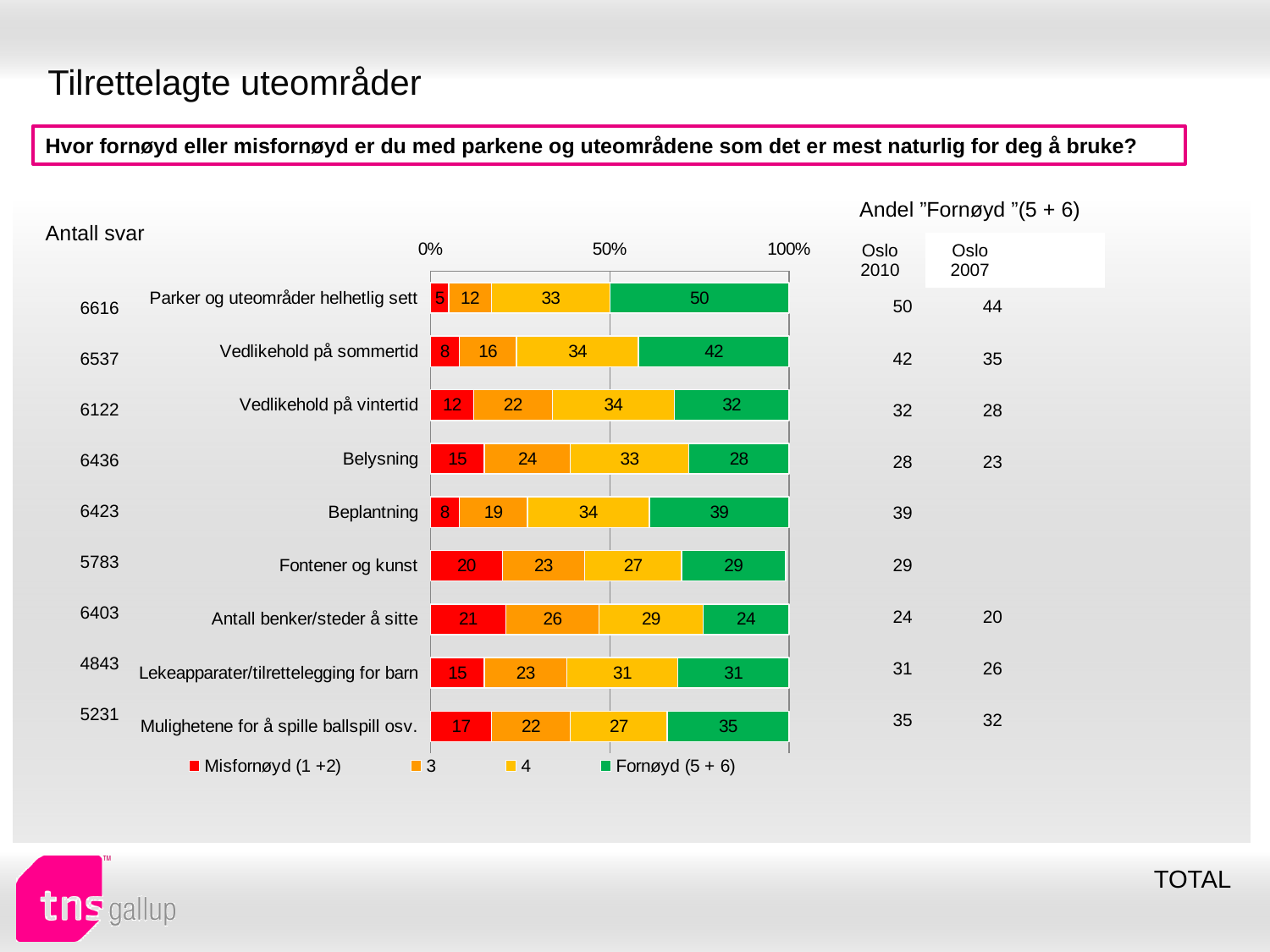
How many series does the legend list? 4 What is the value of the "4" series for "Vedlikehold på vintertid"? 34 Which category has the lowest value for the "Fornøyd (5 + 6)" series? Antall benker/steder å sitte What kind of chart is shown on the slide? Stacked bar chart What is the difference between the "Fornøyd (5 + 6)" values for "Vedlikehold på sommertid" and "Vedlikehold på vintertid"? 10 What is the total of the stacked bar for "Parker og uteområder helhetlig sett"? 100 What is the value of the "Misfornøyd (1 +2)" series for "Antall benker/steder å sitte"? 21 What is the value of the "Fornøyd (5 + 6)" series for "Parker og uteområder helhetlig sett"? 50 Which is larger: the "Misfornøyd (1 +2)" value for "Fontener og kunst" or for "Belysning"? Fontener og kunst How many categories are shown on the chart? 9 Which category has the highest value for the "Fornøyd (5 + 6)" series? Parker og uteområder helhetlig sett Which colour represents the "Fornøyd (5 + 6)" series in the legend? Green